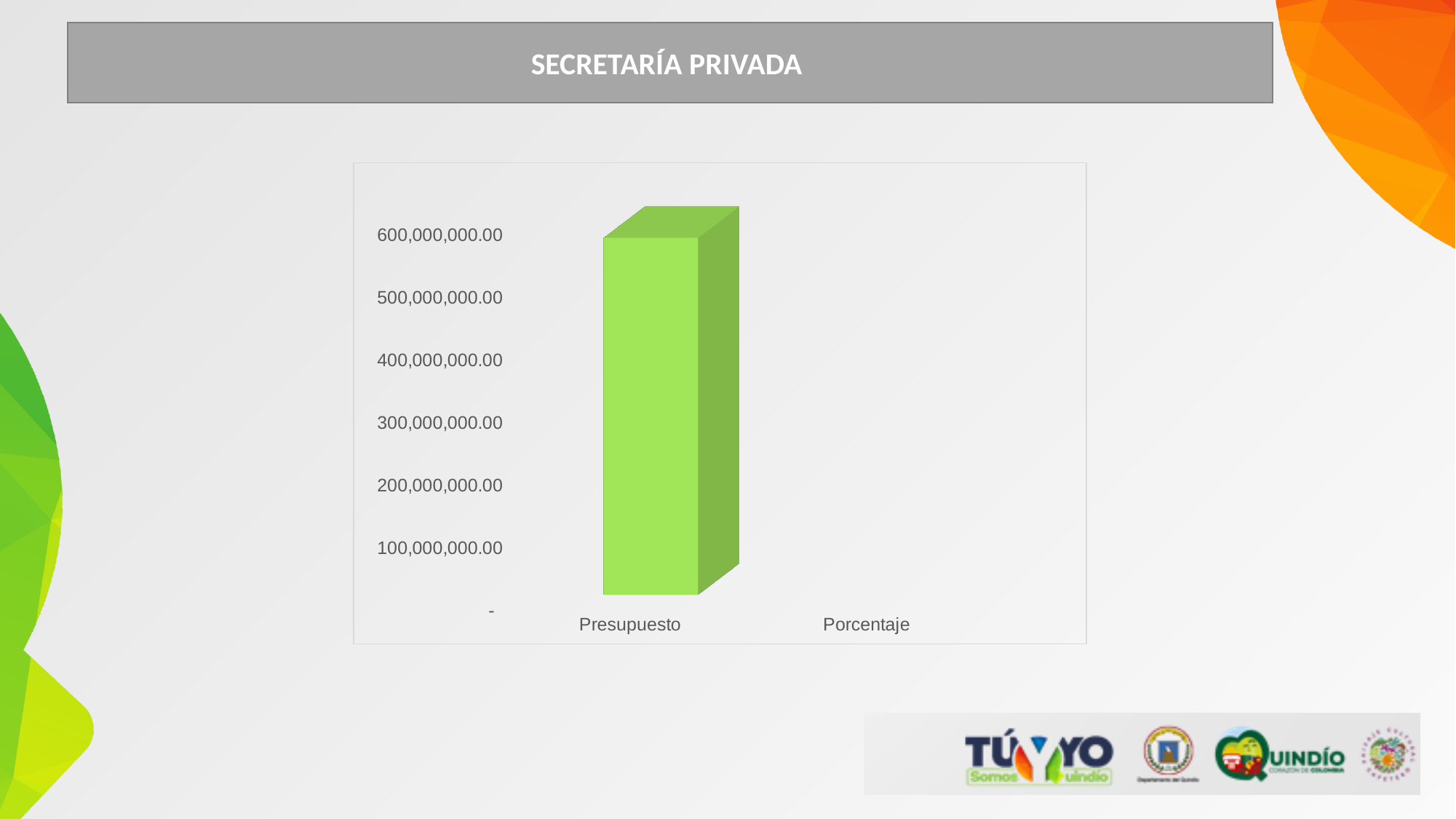
Is the value for Presupuesto greater or less than 500,000,000.00? greater Is the value for Porcentaje greater or less than 100,000,000.00? less What is the highest tick label shown on the vertical axis of the chart? 600,000,000.00 Which is larger, the value for Presupuesto or the value for Porcentaje? Presupuesto Which category has the highest value in the chart? Presupuesto What is the title shown in the header bar above the chart? SECRETARÍA PRIVADA Is the value for Presupuesto greater or less than 400,000,000.00? greater How many categories are shown on the x axis of the chart? 2 What kind of chart is shown on the slide? bar chart Which category has the lowest value in the chart? Porcentaje